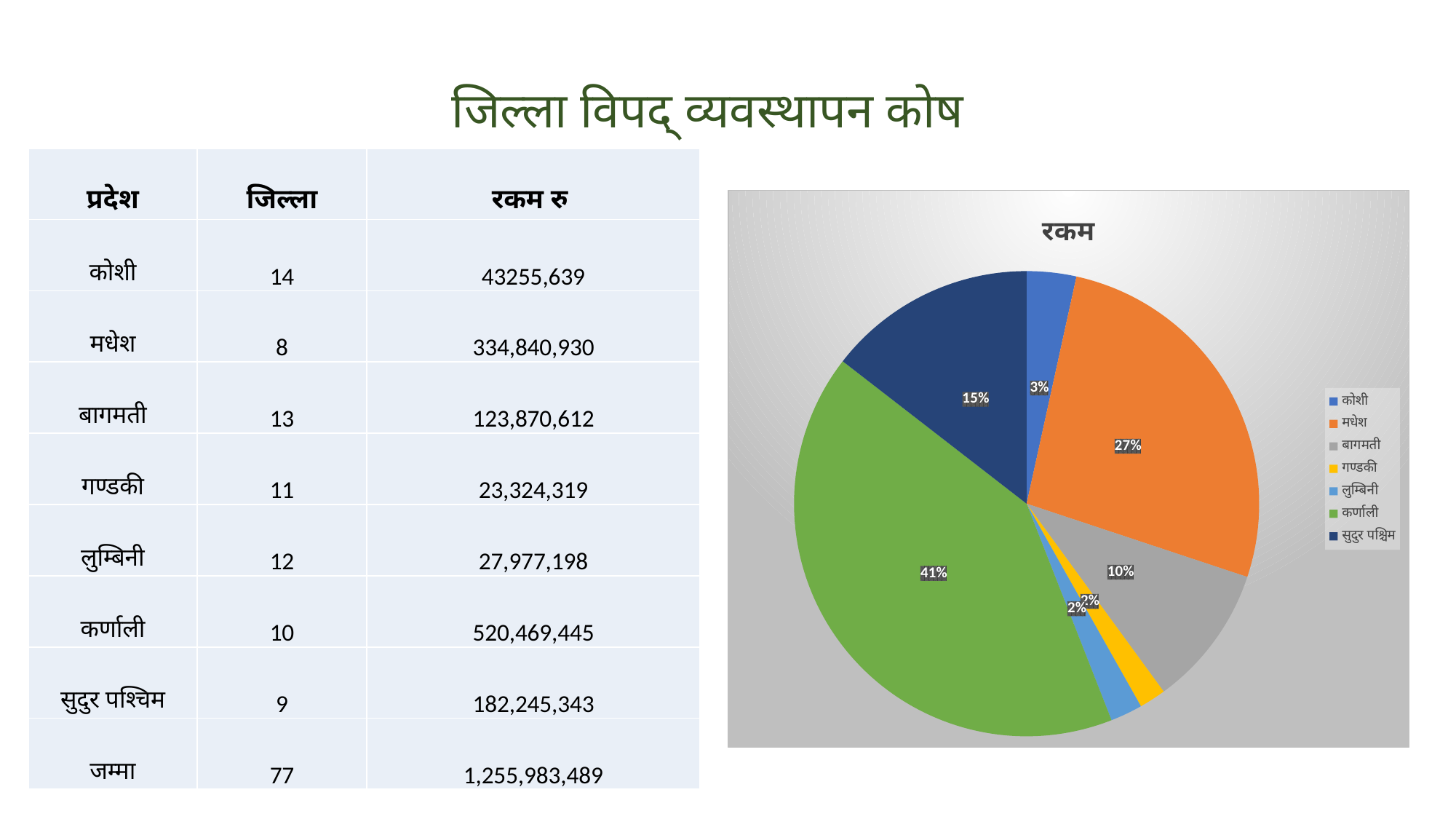
What share of the pie does कर्णाली have? 41% What is the difference in percentage points between the कर्णाली slice and the मधेश slice? 14% How many entries does the legend of the pie chart list? 7 What share of the pie does मधेश have? 27% What kind of chart is shown on the slide? pie chart How many slices does the pie chart have? 7 What is the title of the pie chart? रकम What share of the pie does बागमती have? 10% Which category has the largest slice of the pie chart? कर्णाली Which slice is larger, मधेश or सुदुर पश्चिम? मधेश